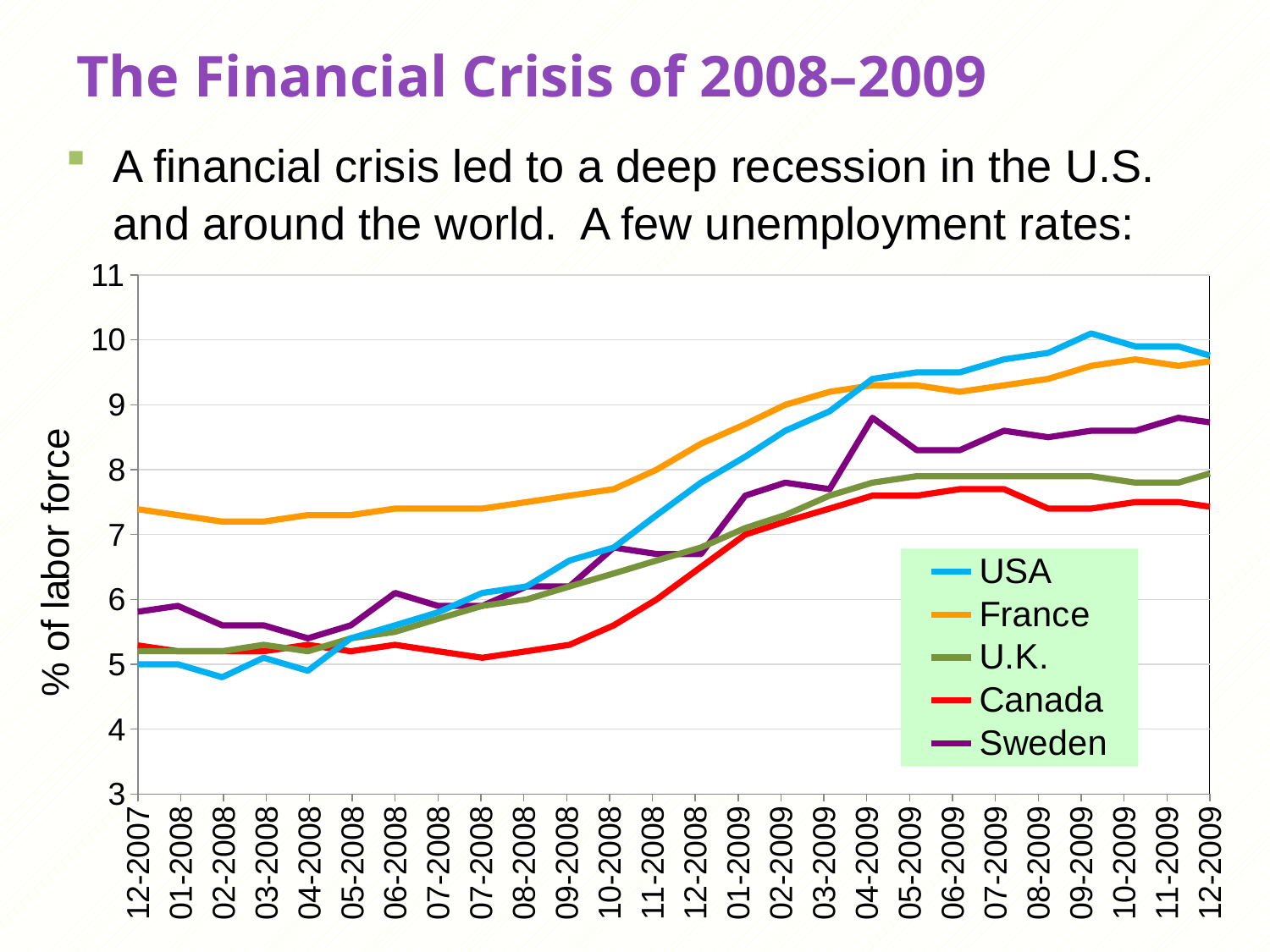
How many series does the legend list? 5 What is the label on the vertical axis? % of labor force Which country has the highest unemployment rate at 09-2009? USA Which series is plotted with the orange line? France At 01-2009, which is larger, the value for France or the value for Canada? France What kind of chart is shown on the slide? Line chart Does the USA unemployment rate rise or fall from 12-2007 to 12-2009? Rise Which country has the lowest unemployment rate at 12-2009? Canada Is the value for Canada at 12-2007 greater or less than 6? less Is the value for USA at 12-2009 greater or less than 9? greater Which country has the highest unemployment rate at 12-2007? France Is the value for Sweden at 04-2009 greater or less than 8? greater